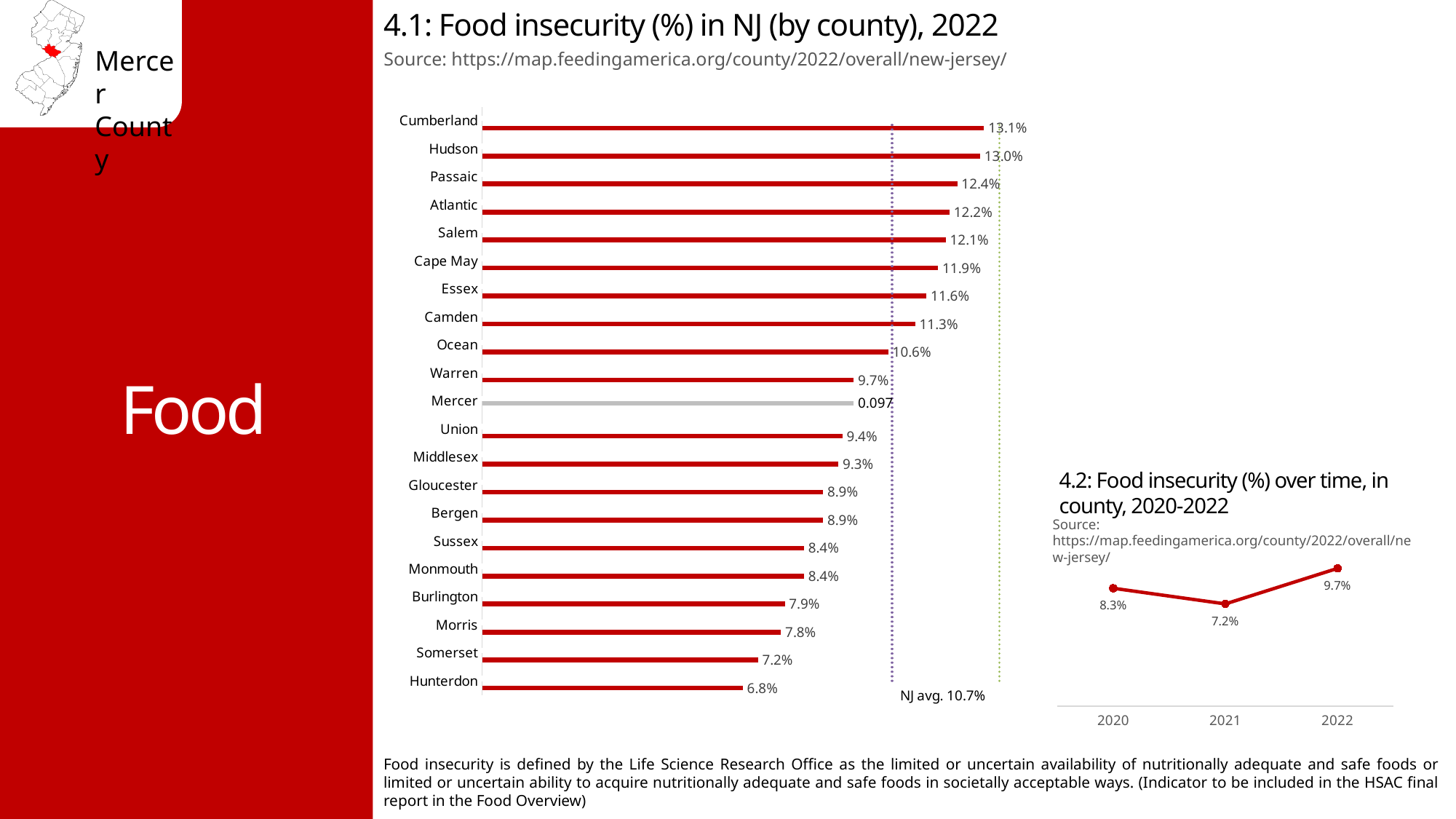
In the chart '4.1: Food insecurity (%) in NJ (by county), 2022', which has the larger value, Passaic or Atlantic? Passaic In the chart '4.1: Food insecurity (%) in NJ (by county), 2022', which county has the lowest value? Hunterdon In the chart '4.1: Food insecurity (%) in NJ (by county), 2022', what label is printed next to the Mercer bar? 0.097 In the chart '4.1: Food insecurity (%) in NJ (by county), 2022', what is the value for Hunterdon? 6.8% In the chart '4.1: Food insecurity (%) in NJ (by county), 2022', what is the difference between the values for Cumberland and Hunterdon? 6.3 percentage points In the chart '4.1: Food insecurity (%) in NJ (by county), 2022', what is the value for Cumberland? 13.1% In the chart '4.2: Food insecurity (%) over time, in county, 2020-2022', how does the value change from 2020 to 2022? It falls from 2020 to 2021, then rises in 2022 What kind of chart is '4.1: Food insecurity (%) in NJ (by county), 2022'? Bar chart In the chart '4.2: Food insecurity (%) over time, in county, 2020-2022', what is the value for 2021? 7.2% In the chart '4.1: Food insecurity (%) in NJ (by county), 2022', what NJ average value is noted next to the dotted reference line? 10.7% How many counties are shown in the chart '4.1: Food insecurity (%) in NJ (by county), 2022'? 21 In the chart '4.1: Food insecurity (%) in NJ (by county), 2022', which county has the highest value? Cumberland